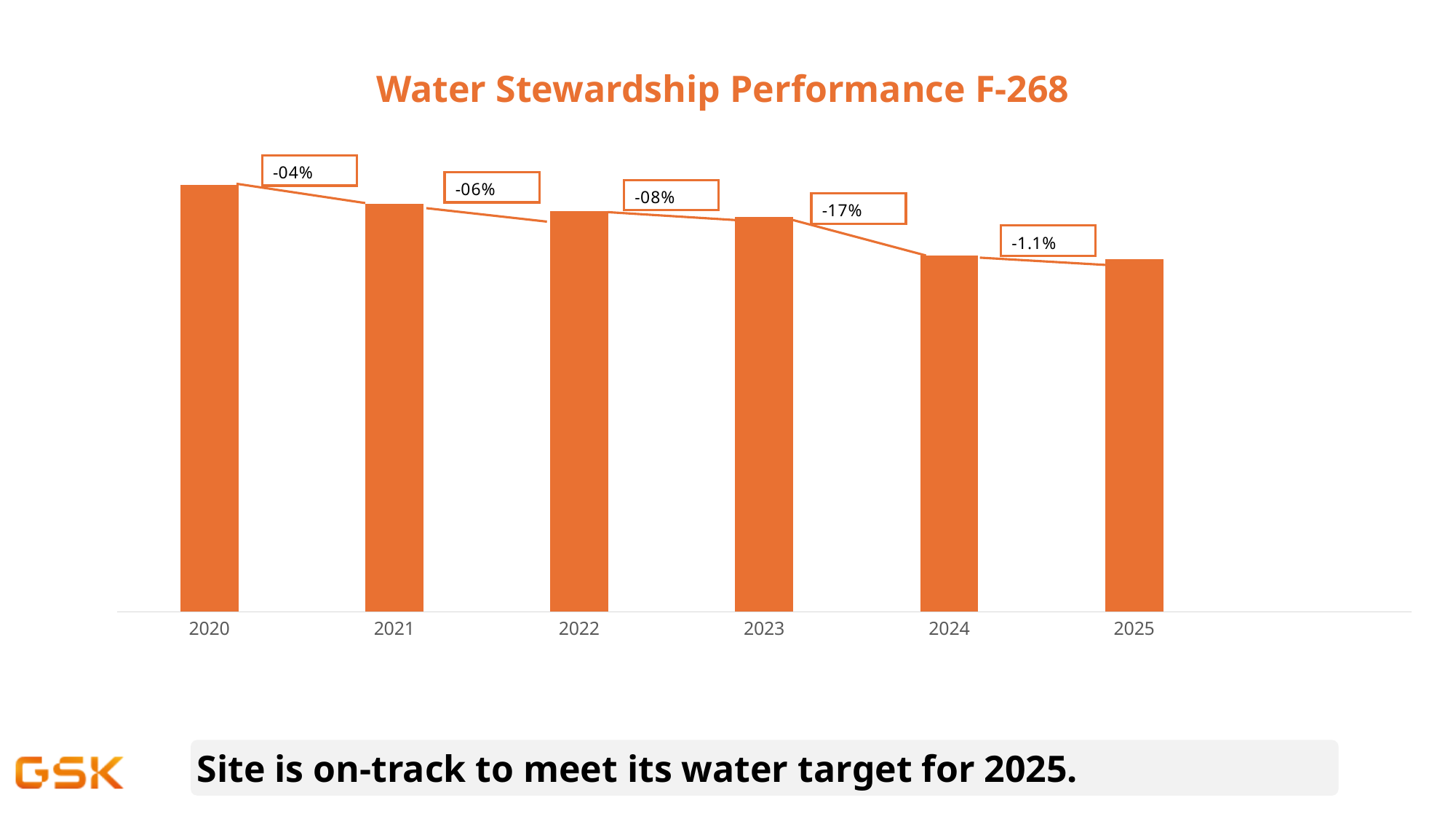
Which year has the shortest bar in the chart? 2025 What percentage change label is shown between the 2024 and 2025 bars? -1.1% What percentage change label is shown between the 2021 and 2022 bars? -06% How many years are shown on the x axis of the chart? 6 What type of chart is shown on the slide? bar chart What percentage change label is shown between the 2020 and 2021 bars? -04% Which bar is taller, 2020 or 2024? 2020 Do the bar values rise or fall from 2020 to 2025? fall What is the title of the chart? Water Stewardship Performance F-268 Which year has the tallest bar in the chart? 2020 Which bar is taller, 2021 or 2025? 2021 What percentage change label is shown between the 2023 and 2024 bars? -17%